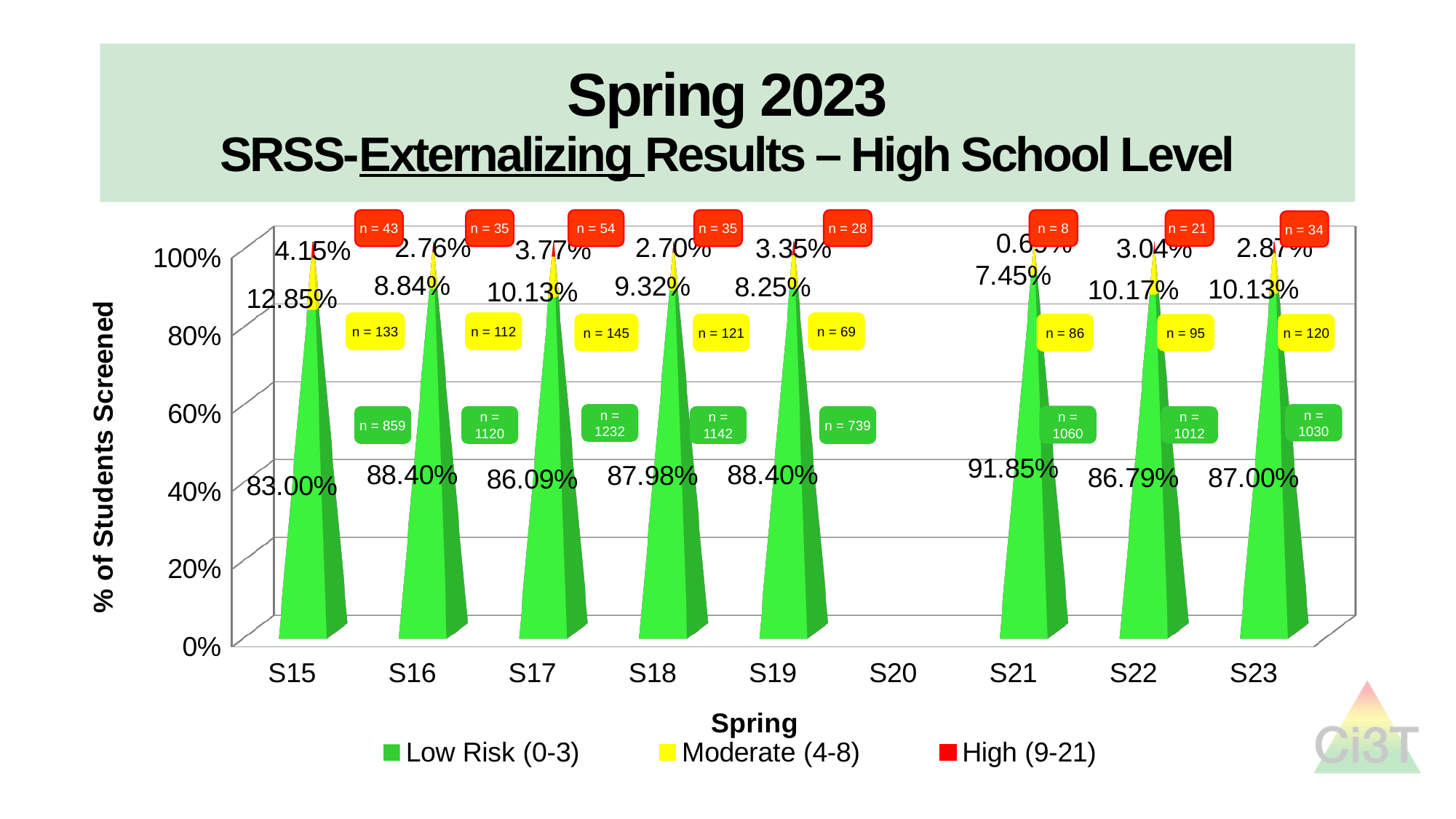
What is the n value shown for the Low Risk group in S17? n = 1232 Which spring has the highest High (9-21) percentage? S15 Which spring has the highest Low Risk (0-3) percentage? S21 Which spring has the lowest Low Risk (0-3) percentage? S15 How many springs have data plotted on the chart? 8 What is the Low Risk (0-3) percentage for S15? 83.00% What kind of chart is shown on the slide? Stacked bar chart What is the Moderate (4-8) percentage for S17? 10.13% Which has a larger Moderate (4-8) percentage, S22 or S19? S22 What is the difference between the Low Risk percentages for S16 and S15? 5.40% How many series does the legend list? 3 What is the High (9-21) percentage for S18? 2.70%